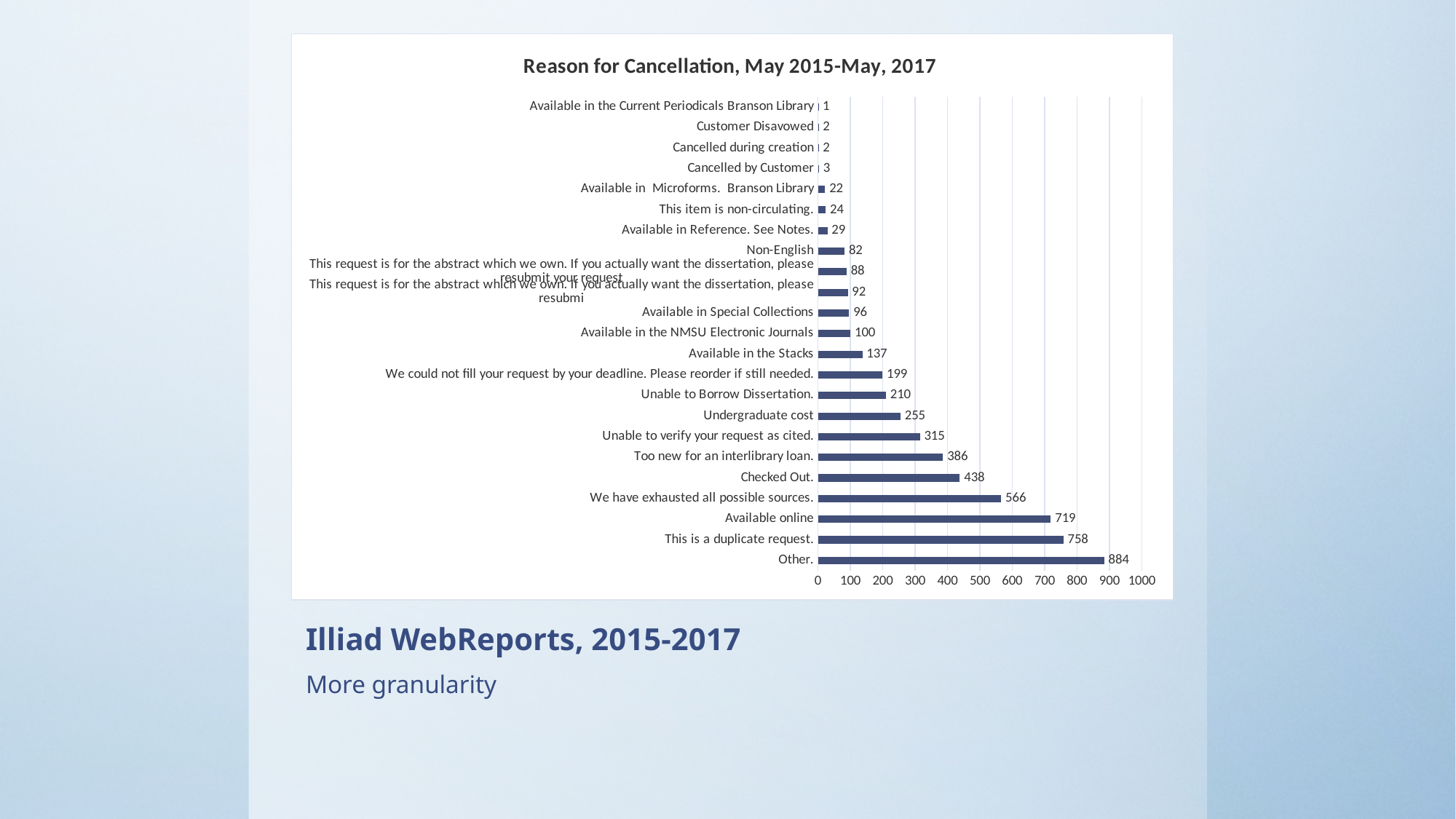
What is the value for "Checked Out."? 438 What is the value for "Other."? 884 Which reason for cancellation has the highest value? Other. What kind of chart is shown on the slide? bar chart What is the value for "Undergraduate cost"? 255 What is the difference between "This is a duplicate request." and "Available online"? 39 What is the title of the chart? Reason for Cancellation, May 2015-May, 2017 Which is larger, "Too new for an interlibrary loan." or "Unable to verify your request as cited."? Too new for an interlibrary loan. Is the value for "We have exhausted all possible sources." greater or less than 500? greater What is the value for "Available online"? 719 How many categories are shown in the chart? 23 Which reason for cancellation has the lowest value? Available in the Current Periodicals Branson Library